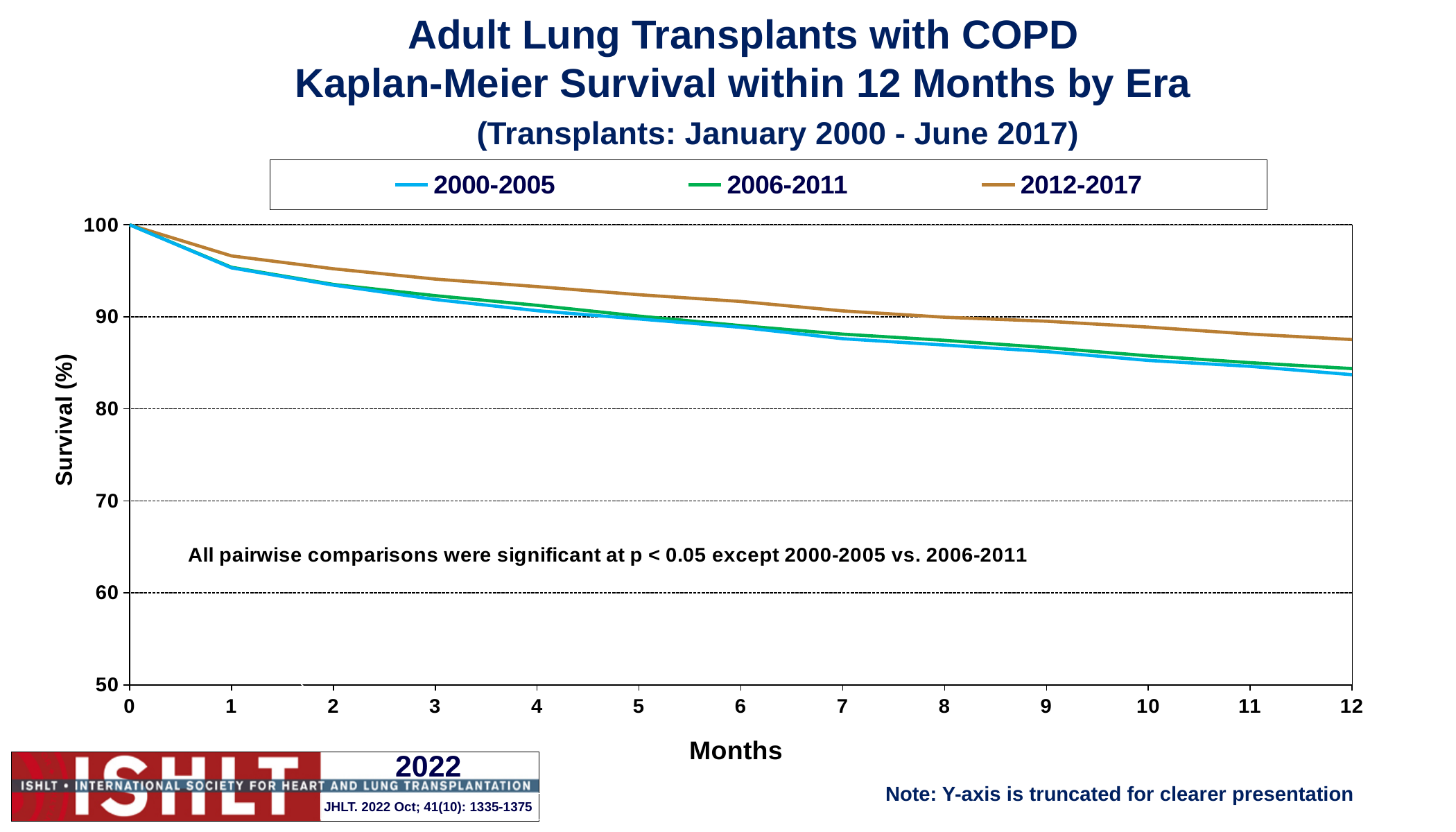
What kind of chart is shown on the slide? Line chart What is the label of the y-axis? Survival (%) Is the survival value for 2000-2005 at 3 months greater or less than 90? greater Do the survival curves rise or fall as months increase? Fall Which era has the highest survival at 12 months? 2012-2017 Is the survival value for 2012-2017 at 6 months greater or less than 90? greater What is the survival value for the 2012-2017 series at month 0? 100 How many series does the legend list? 3 At 12 months, which is larger: the survival for 2012-2017 or for 2000-2005? 2012-2017 Is the survival value for 2000-2005 at 12 months greater or less than 80? greater Which era is plotted with the brown line? 2012-2017